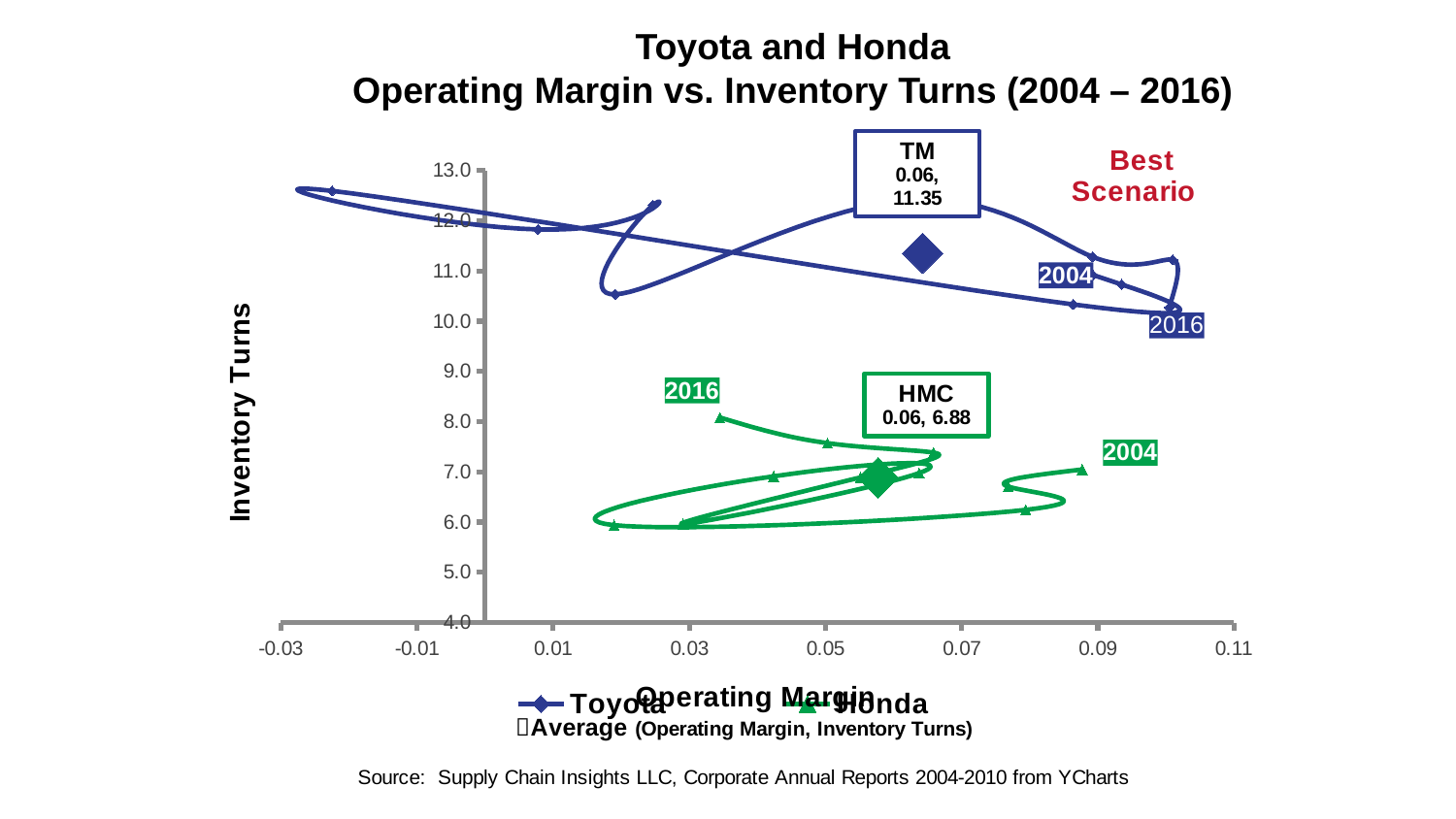
Which company has the higher average inventory turns, Toyota or Honda? Toyota What is the average operating margin shown for HMC (Honda)? 0.06 What is the difference between Toyota's average inventory turns (11.35) and Honda's average inventory turns (6.88)? 4.47 What is the label on the vertical axis of the chart? Inventory Turns What is the average inventory turns value shown for TM (Toyota)? 11.35 Which two companies are plotted as series in the chart? Toyota and Honda What kind of chart is shown on the slide? Scatter chart What is the average operating margin shown for TM (Toyota)? 0.06 What is the average inventory turns value shown for HMC (Honda)? 6.88 What is the title of the chart? Toyota and Honda Operating Margin vs. Inventory Turns (2004 – 2016) Is the inventory turns value for Honda's 2016 point greater or less than 9.0? less Is the inventory turns value for Toyota's 2004 point greater or less than 10.0? greater